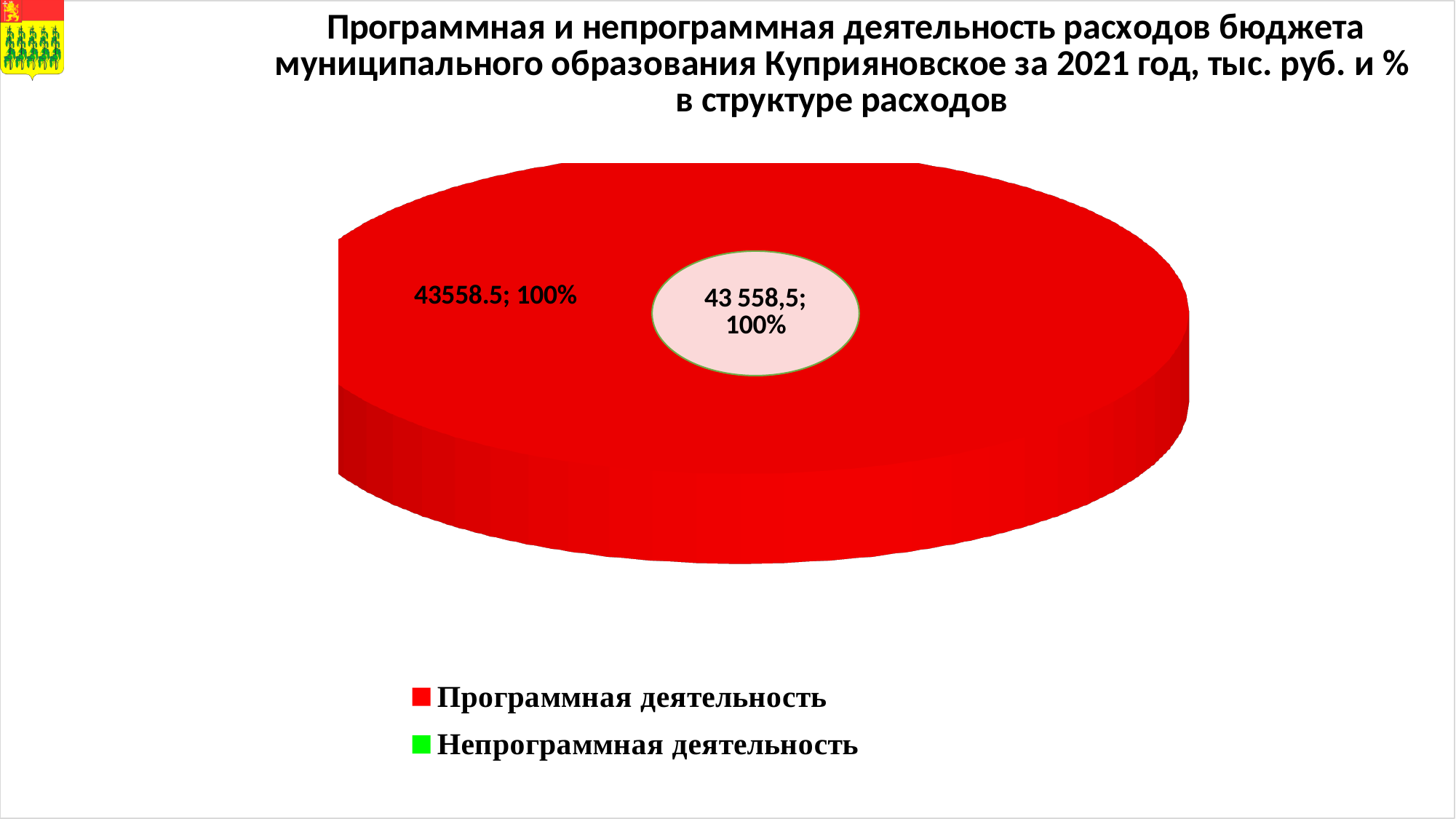
What colour represents Программная деятельность in the pie chart? red What type of chart is shown on the slide? pie chart How many slices are visibly drawn in the pie chart? 1 What share of expenditures does Программная деятельность account for according to the pie chart? 100% What value is shown for Программная деятельность in the pie chart? 43558.5 Which category has the largest share in the pie chart? Программная деятельность Which is larger in the pie chart, Программная деятельность or Непрограммная деятельность? Программная деятельность How many entries does the legend of the pie chart list? 2 Which year does the chart title say the expenditure data refers to? 2021